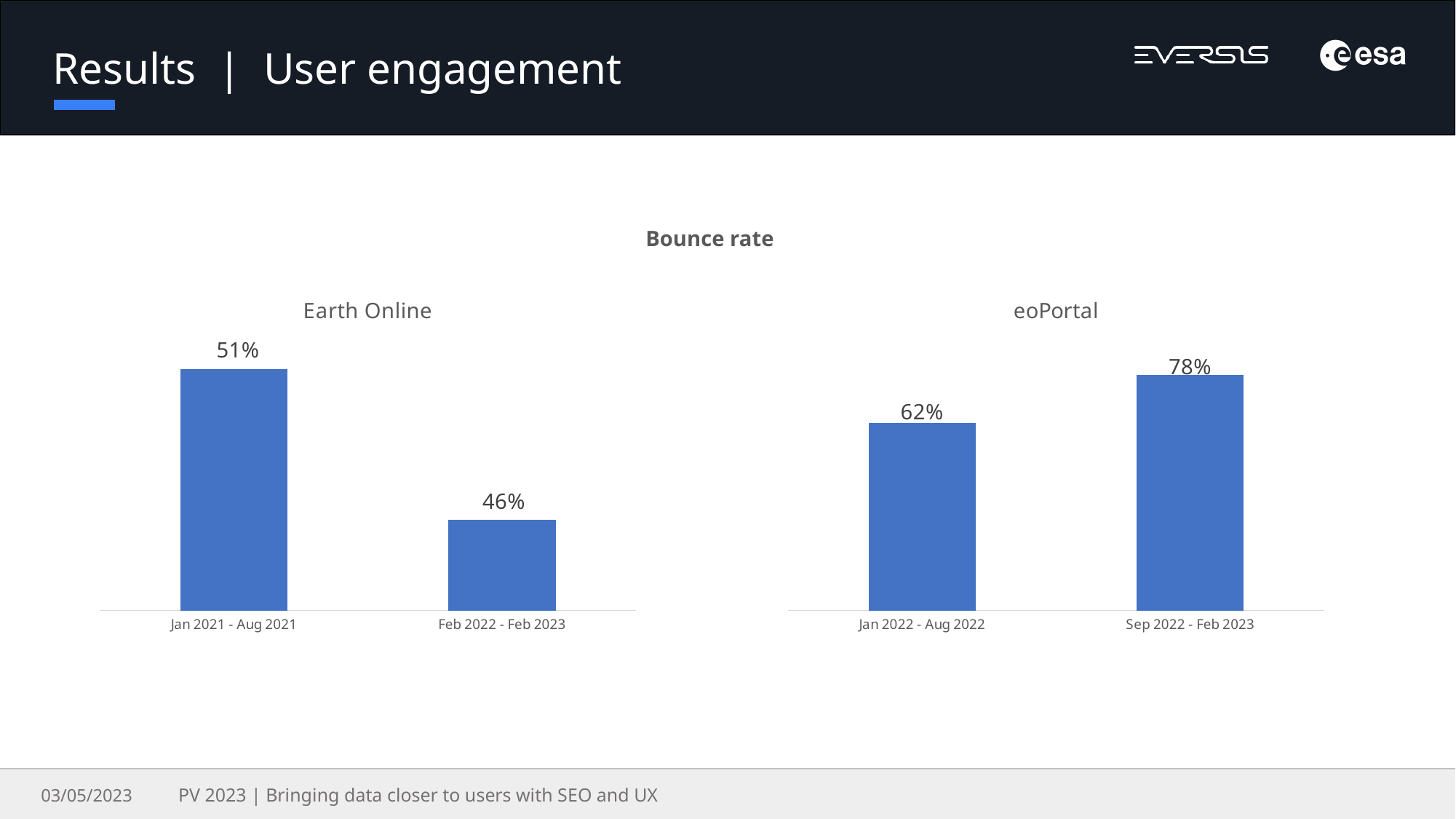
In the Earth Online chart, which period has the higher bounce rate? Jan 2021 - Aug 2021 In the eoPortal chart, which period has the lower bounce rate? Jan 2022 - Aug 2022 In the eoPortal chart, what is the bounce rate for Jan 2022 - Aug 2022? 62% In the eoPortal chart, does the bounce rate rise or fall from the first period to the second? rise In the Earth Online chart, what is the bounce rate for Jan 2021 - Aug 2021? 51% In the Earth Online chart, what is the bounce rate for Feb 2022 - Feb 2023? 46% What type of chart is used for the eoPortal bounce rate? bar chart How many bars are shown in the Earth Online chart? 2 In the eoPortal chart, what is the bounce rate for Sep 2022 - Feb 2023? 78% Which is larger: the Earth Online bounce rate for Jan 2021 - Aug 2021 or the eoPortal bounce rate for Jan 2022 - Aug 2022? eoPortal Jan 2022 - Aug 2022 In the eoPortal chart, what is the difference between the Sep 2022 - Feb 2023 and Jan 2022 - Aug 2022 bounce rates? 16 percentage points In the Earth Online chart, by how many percentage points did the bounce rate fall from Jan 2021 - Aug 2021 to Feb 2022 - Feb 2023? 5 percentage points